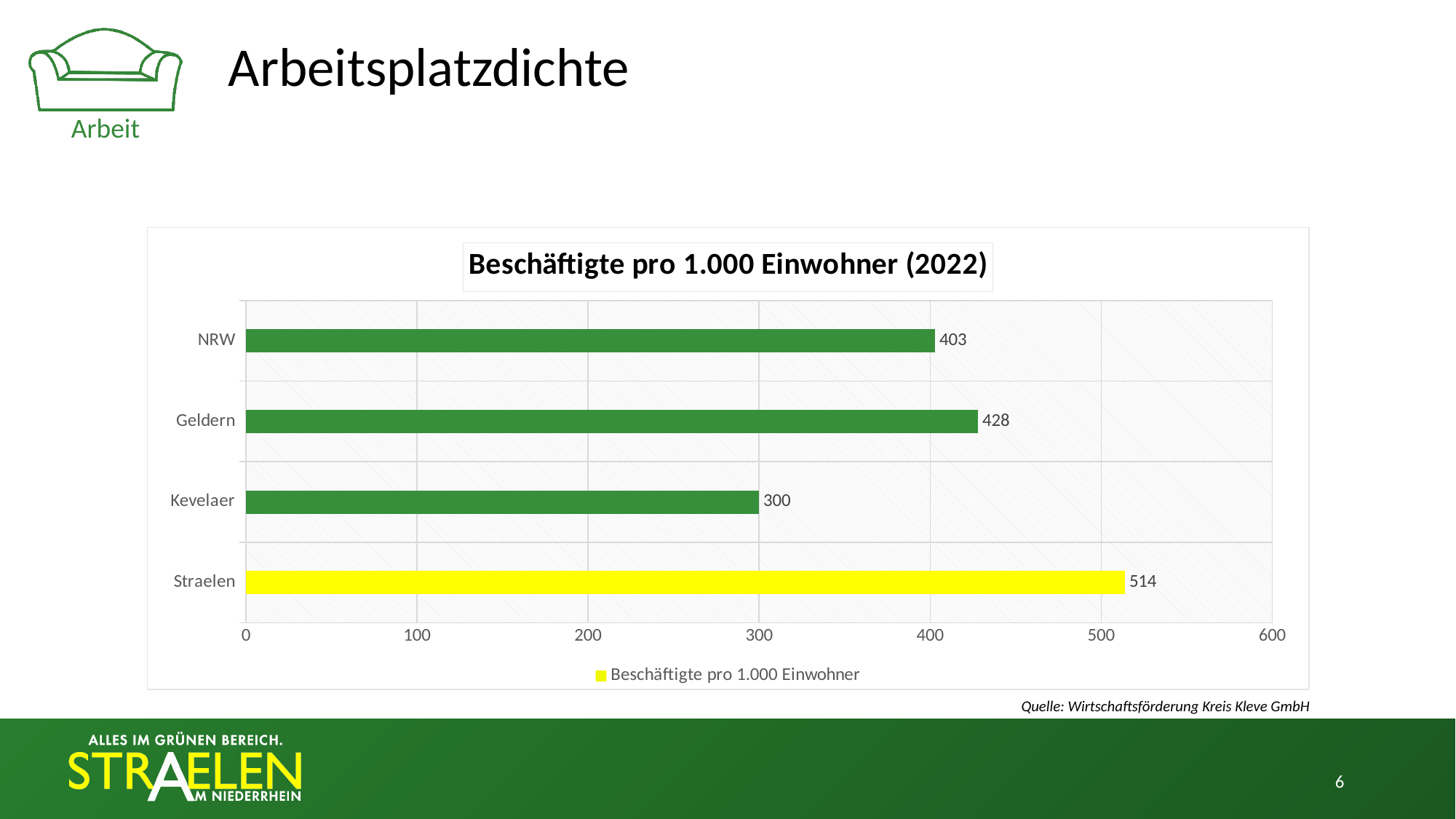
What is the value for Kevelaer in the chart? 300 What is the value for NRW in the chart? 403 What is the value for Geldern in the chart? 428 What is the difference between the values for Geldern and NRW? 25 What is the title of the chart? Beschäftigte pro 1.000 Einwohner (2022) How many categories are shown in the chart? 4 What is the difference between the values for Straelen and Kevelaer? 214 Which category has the lowest value? Kevelaer What is the value for Straelen in the chart? 514 Which category has the highest value? Straelen What kind of chart is shown on the slide? Bar chart Which has a larger value, Geldern or NRW? Geldern